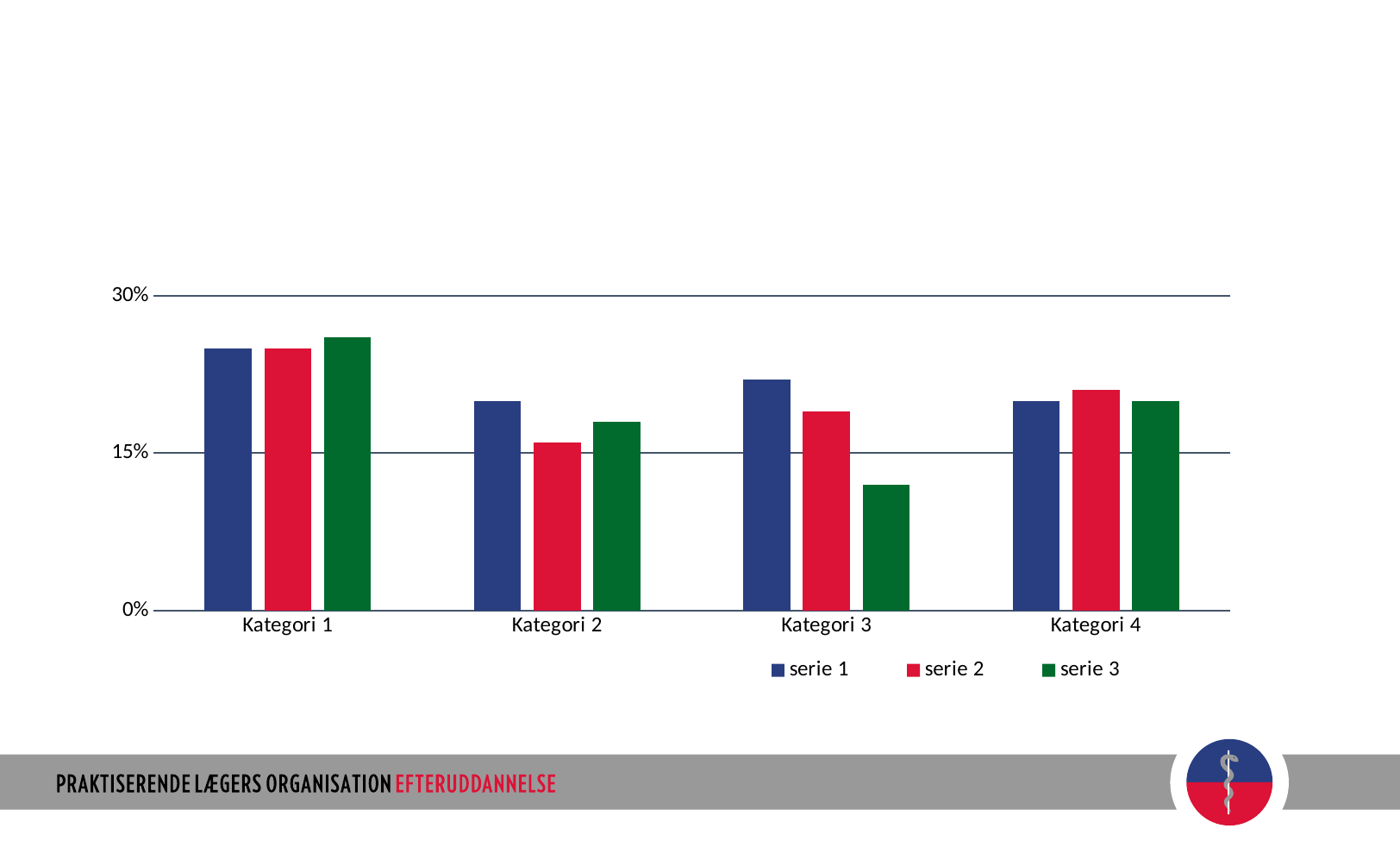
In Kategori 3, which is larger: serie 1 or serie 3? serie 1 Is the value for serie 3 in Kategori 3 greater or less than 15%? less Which category has the highest value for serie 3? Kategori 1 What kind of chart is shown on the slide? bar chart Is the value for serie 1 in Kategori 1 greater or less than 15%? greater What colour are the bars for serie 2? red Which category has the lowest value for serie 2? Kategori 2 In Kategori 2, which is larger: serie 1 or serie 2? serie 1 How many categories are shown on the x axis? 4 Is the value for serie 3 in Kategori 1 greater or less than 30%? less How many series does the legend list? 3 Which category has the lowest value for serie 3? Kategori 3